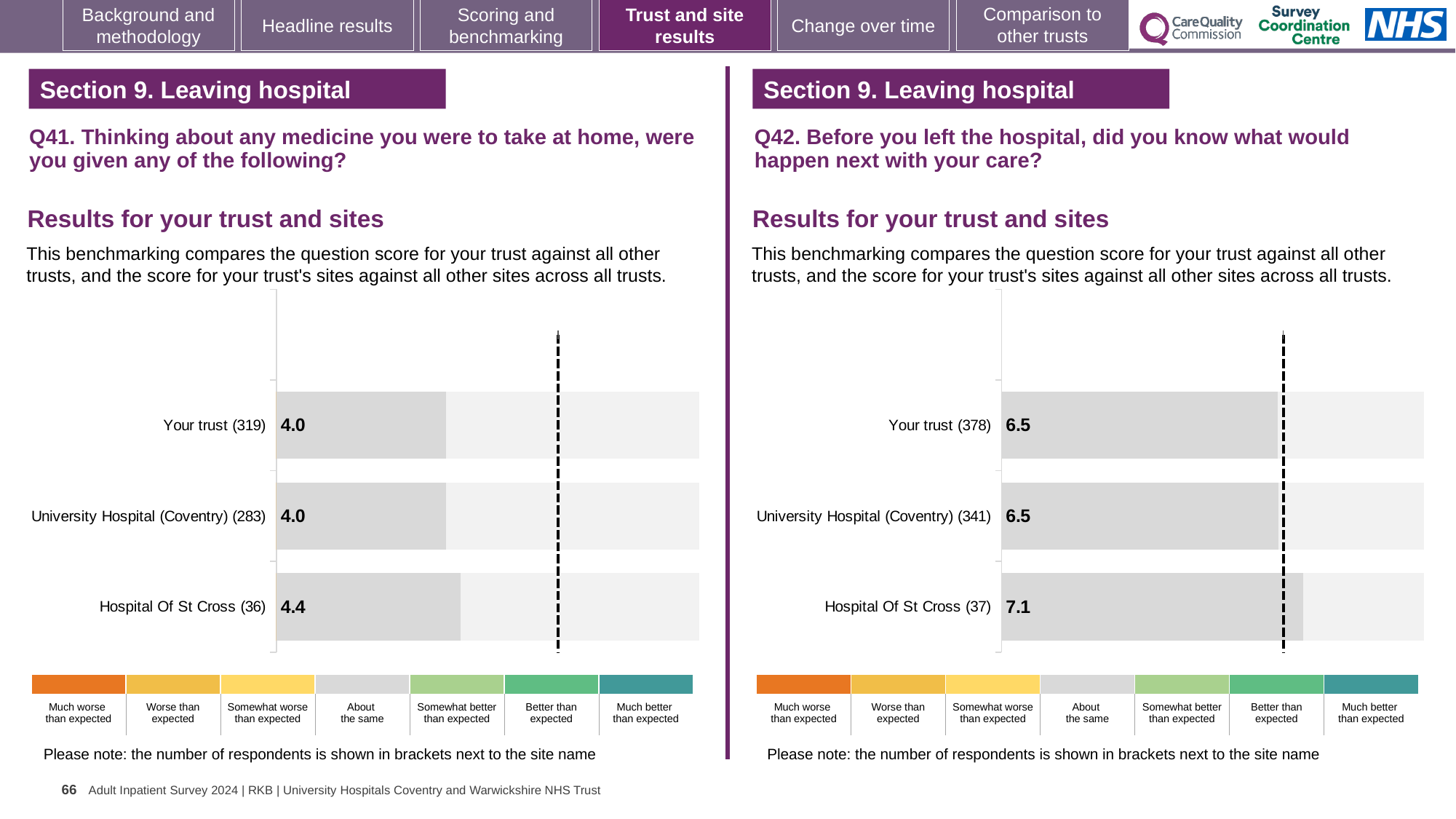
What kind of chart is used for the Q42 results on the right? bar chart In the Q41 chart on the left, what is the difference between the scores for Hospital Of St Cross and University Hospital (Coventry)? 0.4 In the Q42 chart on the right, what is the score for Hospital Of St Cross? 7.1 In the Q41 chart on the left, what is the score for Your trust? 4.0 In the Q41 chart on the left, how many respondents are shown in brackets for Your trust? 319 In the Q42 chart on the right, what is the score for University Hospital (Coventry)? 6.5 In the Q41 chart on the left, which site or trust has the highest score? Hospital Of St Cross In the Q41 chart on the left, what is the score for Hospital Of St Cross? 4.4 How many sites or trusts are plotted in the Q41 chart on the left? 3 In the Q42 chart on the right, is the score for Hospital Of St Cross larger or smaller than the score for Your trust? larger In the Q42 chart on the right, which site or trust has the highest score? Hospital Of St Cross In the Q42 chart on the right, what is the difference between the scores for Hospital Of St Cross and Your trust? 0.6